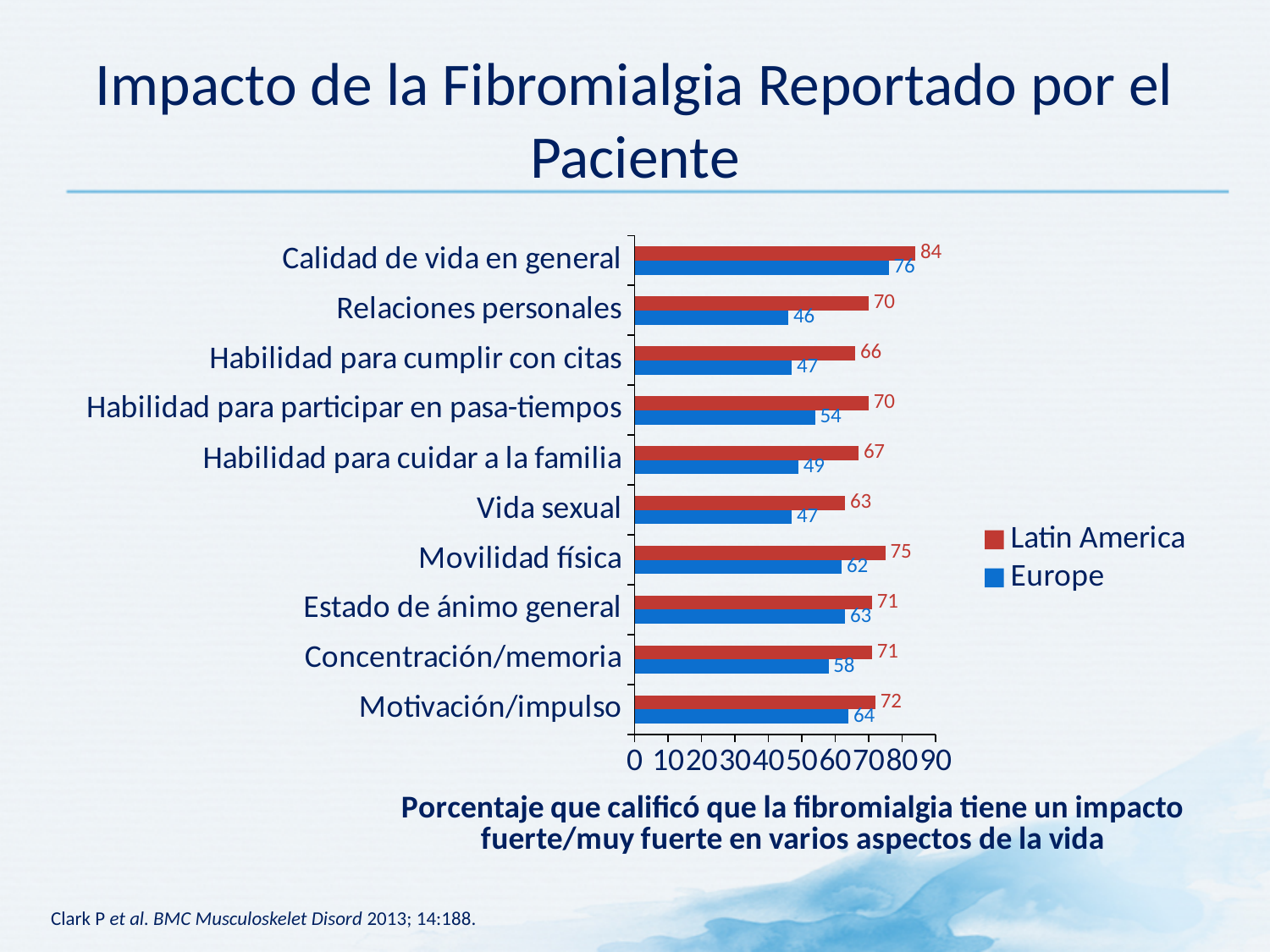
Which is larger for Vida sexual: the Latin America value or the Europe value? Latin America Is the Europe value for Habilidad para cuidar a la familia greater or less than 60? less What is the Latin America value for Calidad de vida en general? 84 What type of chart is shown on the slide? Bar chart Which category has the highest Latin America value? Calidad de vida en general How many categories are shown on the chart? 10 Which colour represents the Europe series in the chart? Blue What is the Europe value for Relaciones personales? 46 How many series does the legend list? 2 What is the difference between the Latin America and Europe values for Relaciones personales? 24 Which category has the lowest Europe value? Relaciones personales What is the Europe value for Movilidad física? 62